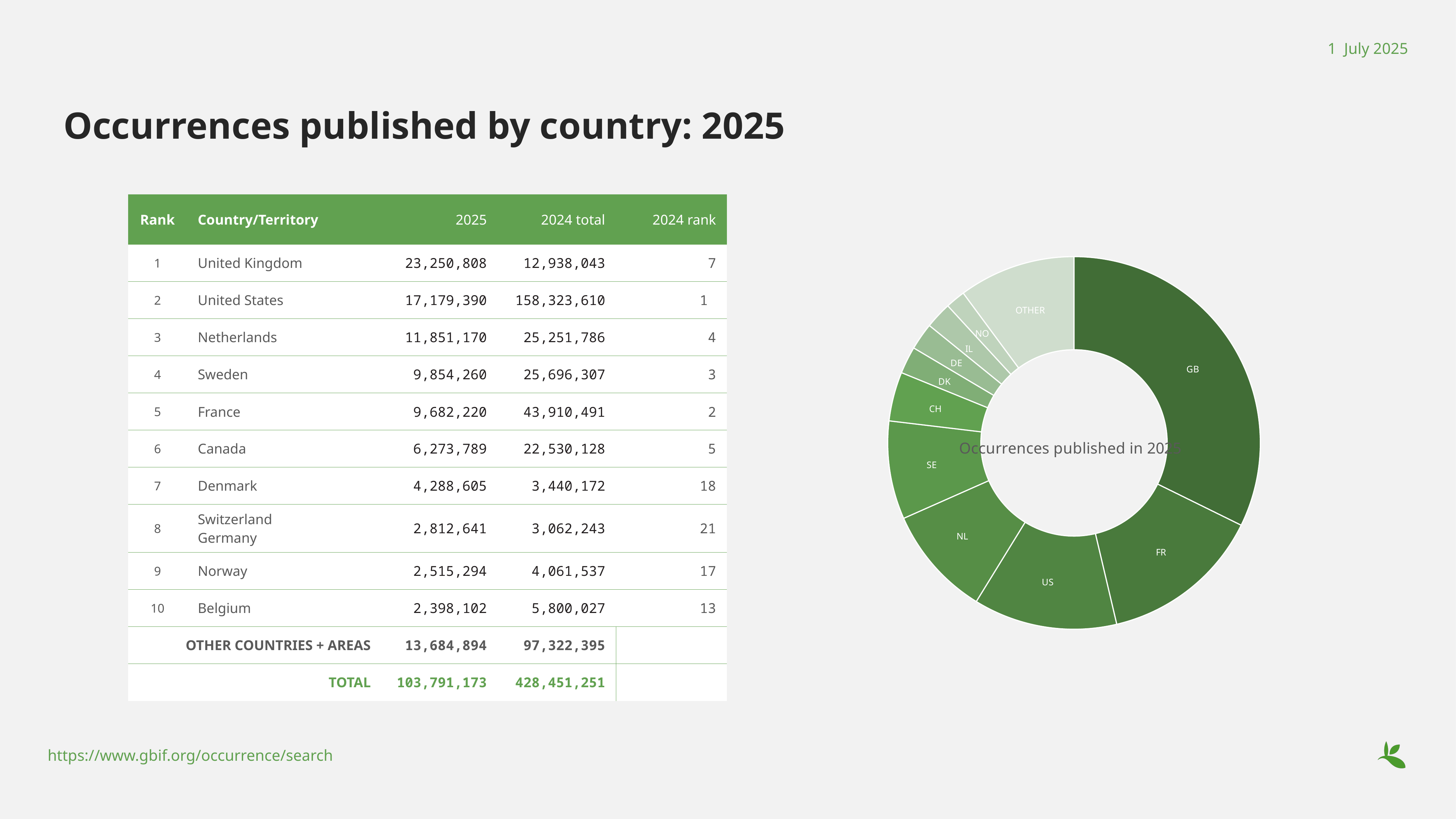
In the donut chart, which slice is larger, OTHER or NO? OTHER In the donut chart, which slice is larger, US or IL? US Which slice of the donut chart is labelled with the darkest green colour? GB Which slice of the donut chart is the largest? GB What is the title shown in the centre of the donut chart? Occurrences published in 2025 How many slices does the donut chart have? 11 In the donut chart, which slice is larger, FR or DK? FR What kind of chart is shown on the right of the slide? Donut (pie) chart